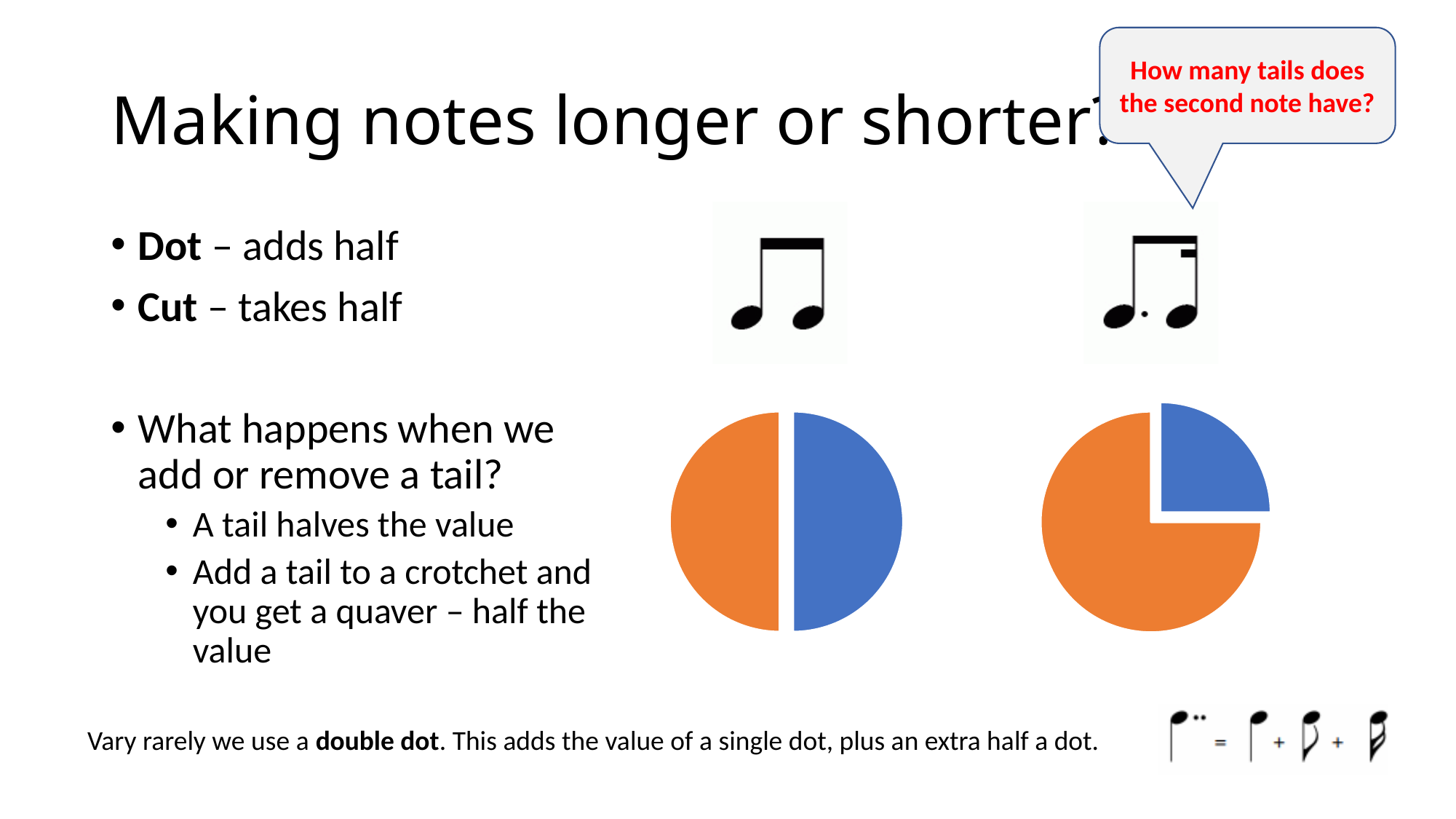
What two colours are used for the slices in the left pie chart? orange and blue How many slices does the left pie chart have? 2 What kind of chart is the left chart on the slide? pie chart How many pie charts are shown on the slide? 2 In the right pie chart, which slice is larger, the orange one or the blue one? orange What kind of chart is the right chart on the slide? pie chart In the right pie chart, which colour is the smallest slice? blue How many slices does the right pie chart have? 2 In the right pie chart, which colour is the largest slice? orange